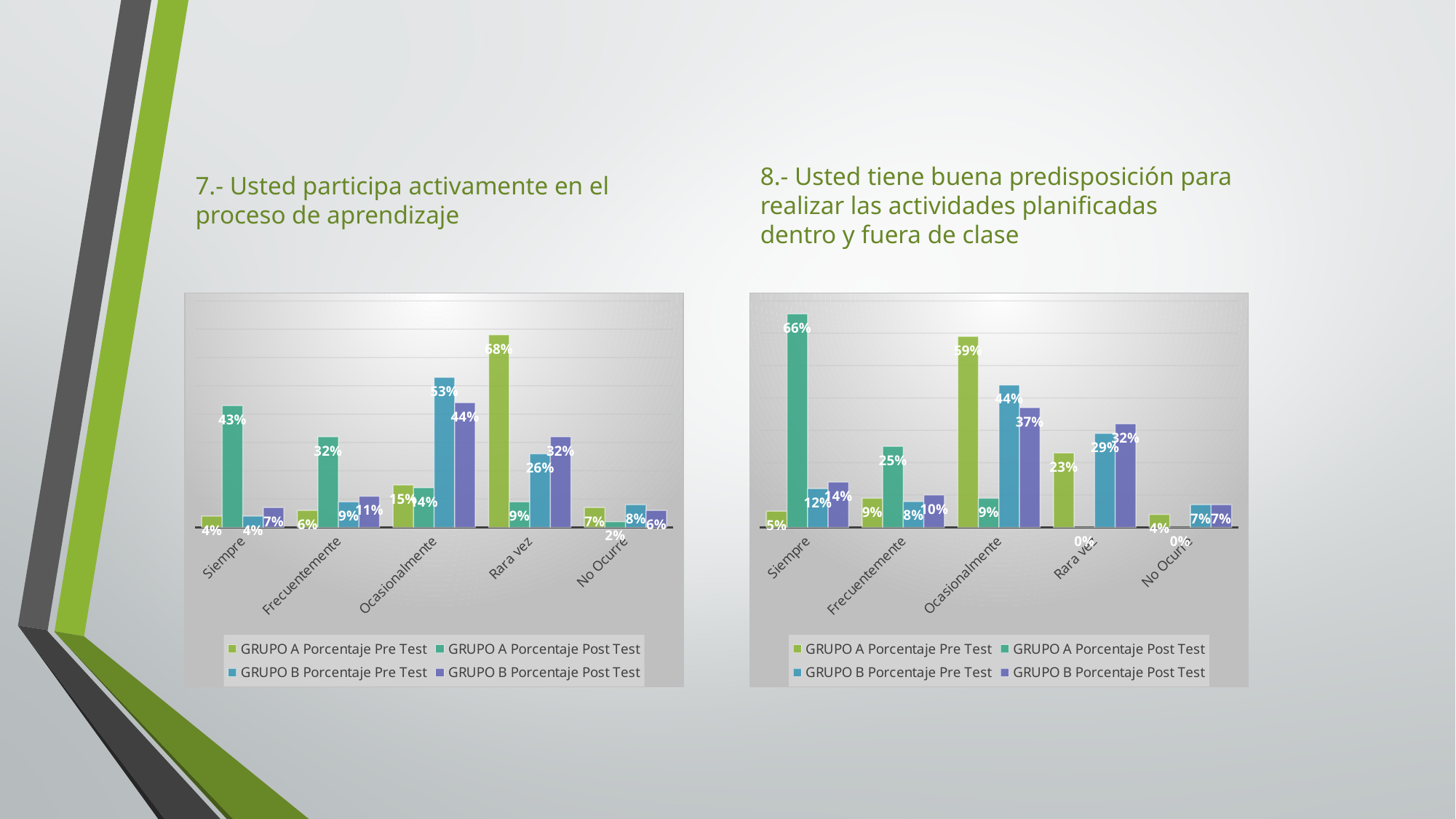
In the right chart (question 8), what is the GRUPO A Porcentaje Post Test value for Siempre? 66% In the right chart (question 8), which is larger for Ocasionalmente: GRUPO B Porcentaje Pre Test or GRUPO B Porcentaje Post Test? GRUPO B Porcentaje Pre Test How many categories are shown on the x axis of the right chart (question 8)? 5 In the left chart (question 7), which category has the lowest GRUPO A Porcentaje Post Test value? No Ocurre In the left chart (question 7), what is the GRUPO B Porcentaje Pre Test value for Ocasionalmente? 53% In the left chart (question 7), which category has the highest GRUPO A Porcentaje Pre Test value? Rara vez In the right chart (question 8), what is the GRUPO B Porcentaje Post Test value for Rara vez? 32% In the left chart (question 7), what is the GRUPO A Porcentaje Post Test value for Siempre? 43% In the right chart (question 8), which category has the highest GRUPO A Porcentaje Pre Test value? Ocasionalmente In the left chart (question 7), what is the difference between the GRUPO A Porcentaje Pre Test and GRUPO A Porcentaje Post Test values for Rara vez? 59% How many series does the legend of the left chart (question 7) list? 4 What kind of chart is the right chart (question 8)? Bar chart